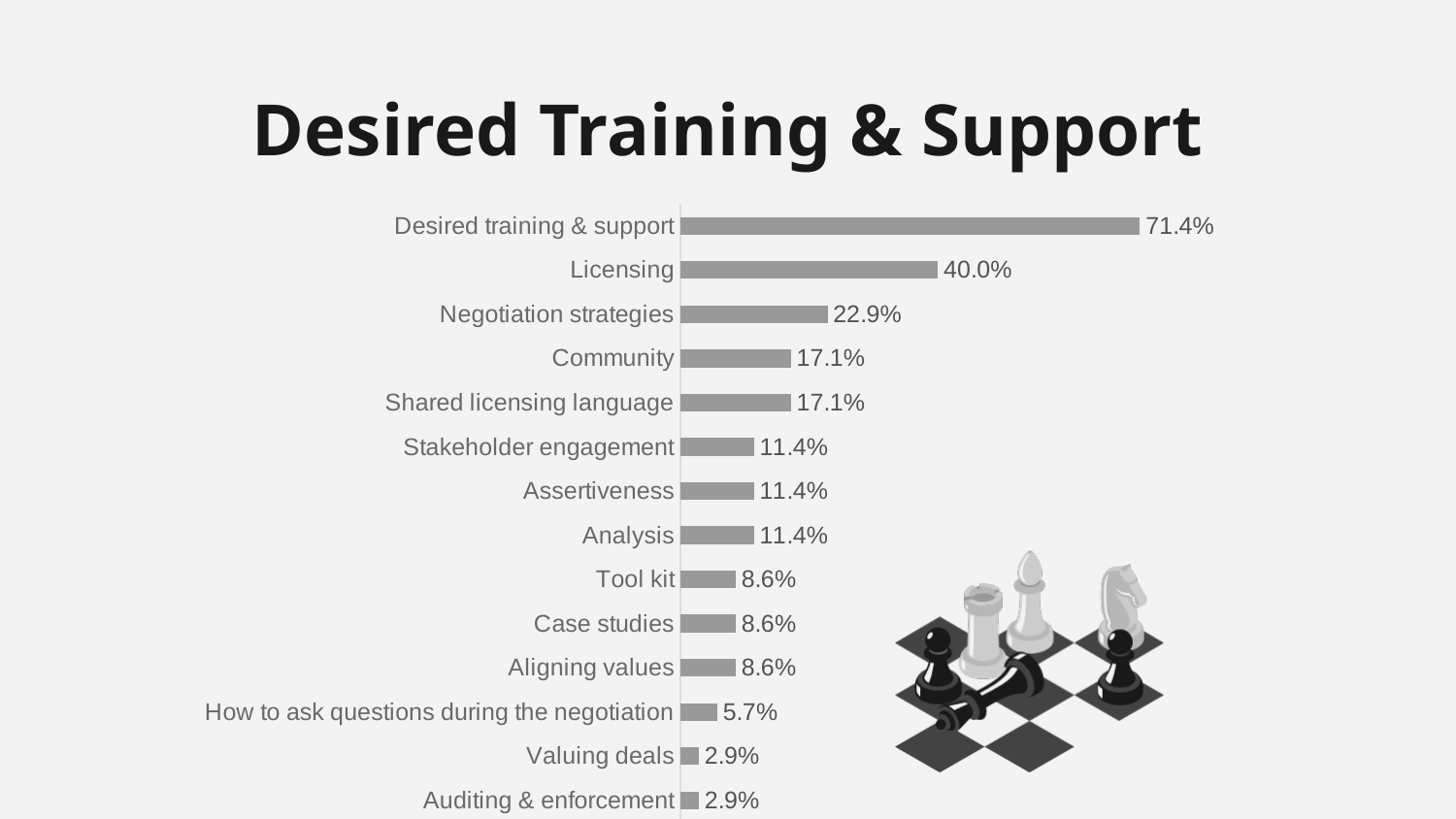
What is the title of the slide? Desired Training & Support What is the value for Stakeholder engagement? 11.4% How many categories are shown in the chart? 14 What kind of chart is shown on the slide? Bar chart What is the value for Auditing & enforcement? 2.9% What is the difference between the values for Desired training & support and Licensing? 31.4% Which is larger, the value for Community or the value for Tool kit? Community Which category has the highest value? Desired training & support What is the value for How to ask questions during the negotiation? 5.7% What is the difference between the values for Licensing and Negotiation strategies? 17.1% What is the value for Negotiation strategies? 22.9% What is the value for Licensing? 40.0%